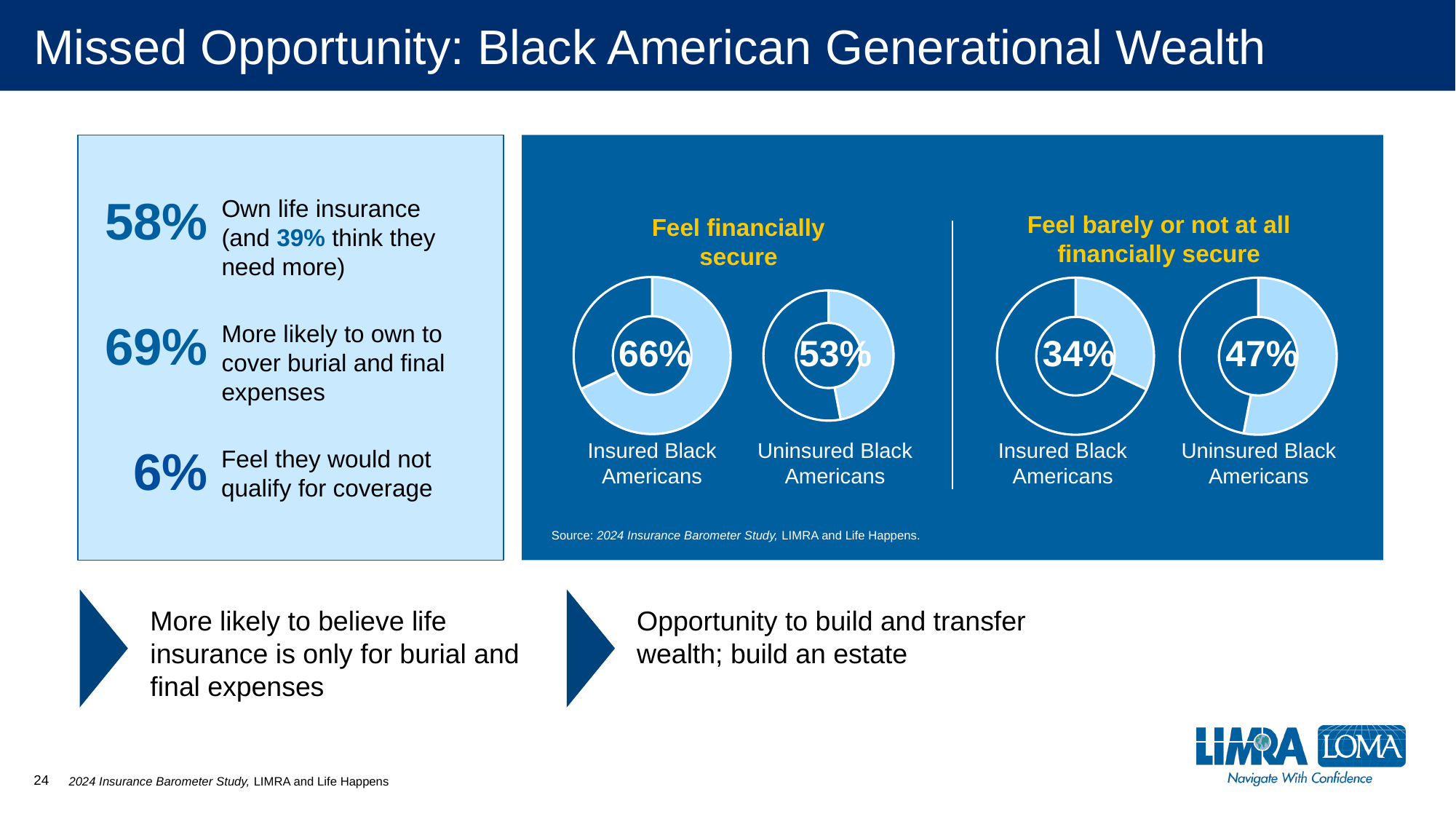
In the "Feel barely or not at all financially secure" charts, what is the difference in percentage points between Uninsured Black Americans and Insured Black Americans? 13 percentage points Across all four donut charts on the slide, which chart shows the highest percentage? Insured Black Americans, Feel financially secure (66%) How many donut charts are shown in the dark blue panel on the slide? 4 In the "Feel barely or not at all financially secure" charts, what percentage of Uninsured Black Americans feel barely or not at all financially secure? 47% Across all four donut charts on the slide, which chart shows the lowest percentage? Insured Black Americans, Feel barely or not at all financially secure (34%) In the "Feel financially secure" charts, what percentage of Insured Black Americans feel financially secure? 66% In the "Feel barely or not at all financially secure" charts, what percentage of Insured Black Americans feel barely or not at all financially secure? 34% In the "Feel financially secure" charts, what percentage of Uninsured Black Americans feel financially secure? 53% In the "Feel financially secure" charts, which group has the higher percentage, Insured Black Americans or Uninsured Black Americans? Insured Black Americans What type of chart is used to show the financial security percentages on the slide? Donut (pie) chart In the "Feel financially secure" charts, what is the difference in percentage points between Insured Black Americans and Uninsured Black Americans? 13 percentage points In the "Feel barely or not at all financially secure" charts, which group has the higher percentage, Insured Black Americans or Uninsured Black Americans? Uninsured Black Americans